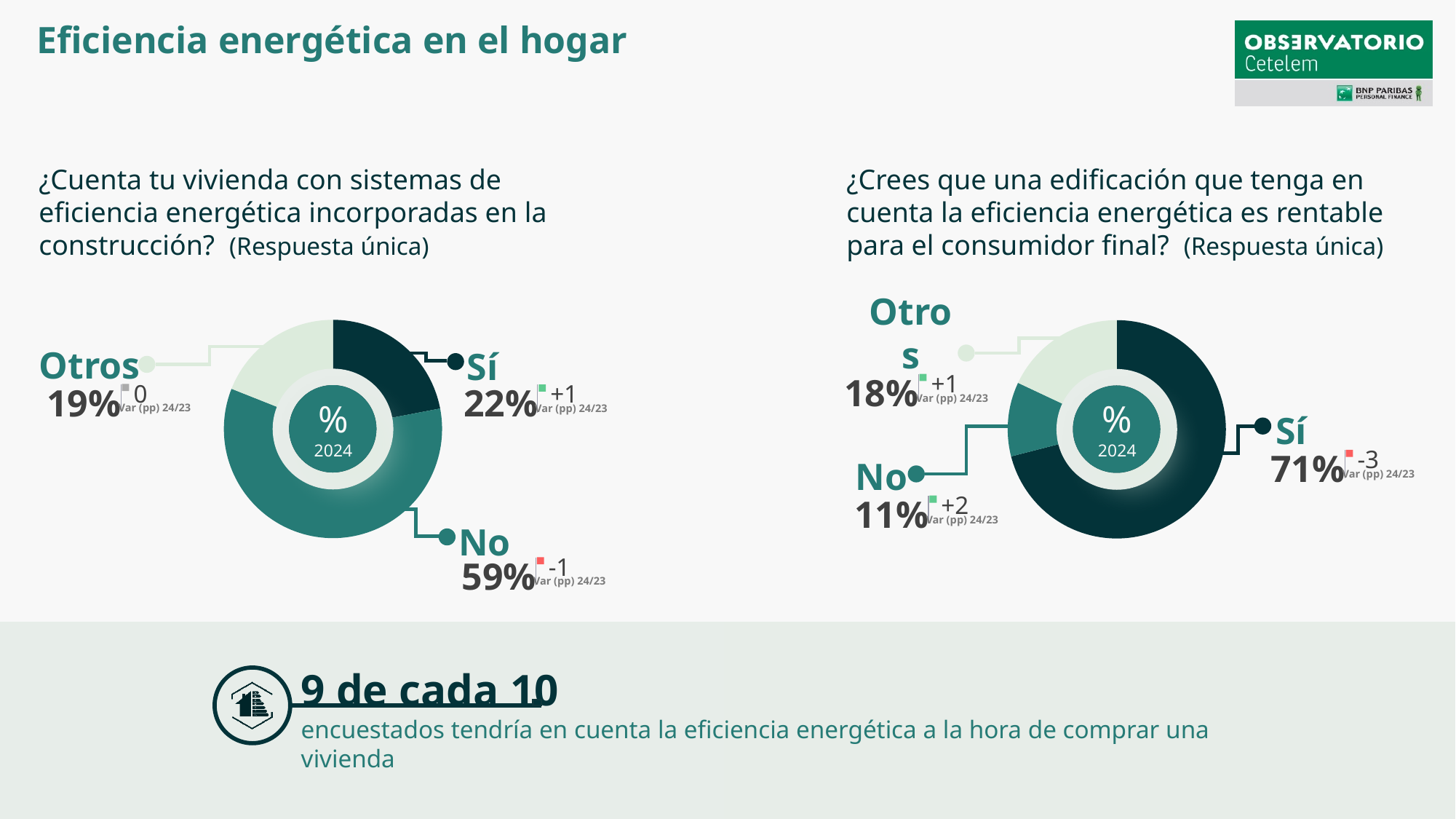
In the right chart (¿Crees que una edificación que tenga en cuenta la eficiencia energética es rentable...?), what is the variation (pp) 24/23 shown for Sí? -3 In the left chart (¿Cuenta tu vivienda con sistemas de eficiencia energética...?), what percentage answered No? 59% In the right chart (¿Crees que una edificación que tenga en cuenta la eficiencia energética es rentable...?), is the share for Otros larger or smaller than the share for No? Otros is larger In the right chart (¿Crees que una edificación que tenga en cuenta la eficiencia energética es rentable...?), what percentage answered Sí? 71% In the right chart (¿Crees que una edificación que tenga en cuenta la eficiencia energética es rentable...?), which response has the smallest share? No In the left chart (¿Cuenta tu vivienda con sistemas de eficiencia energética...?), what percentage answered Sí? 22% How many response categories does the left chart (¿Cuenta tu vivienda con sistemas de eficiencia energética...?) show? 3 In the right chart (¿Crees que una edificación que tenga en cuenta la eficiencia energética es rentable...?), what percentage answered No? 11% In the left chart (¿Cuenta tu vivienda con sistemas de eficiencia energética...?), what is the difference in percentage points between No and Sí? 37 What type of chart is used on the right side of the slide (¿Crees que una edificación... es rentable...?)? Pie chart (donut) In the left chart (¿Cuenta tu vivienda con sistemas de eficiencia energética...?), what is the variation (pp) 24/23 shown for No? -1 In the left chart (¿Cuenta tu vivienda con sistemas de eficiencia energética...?), which response has the largest share? No